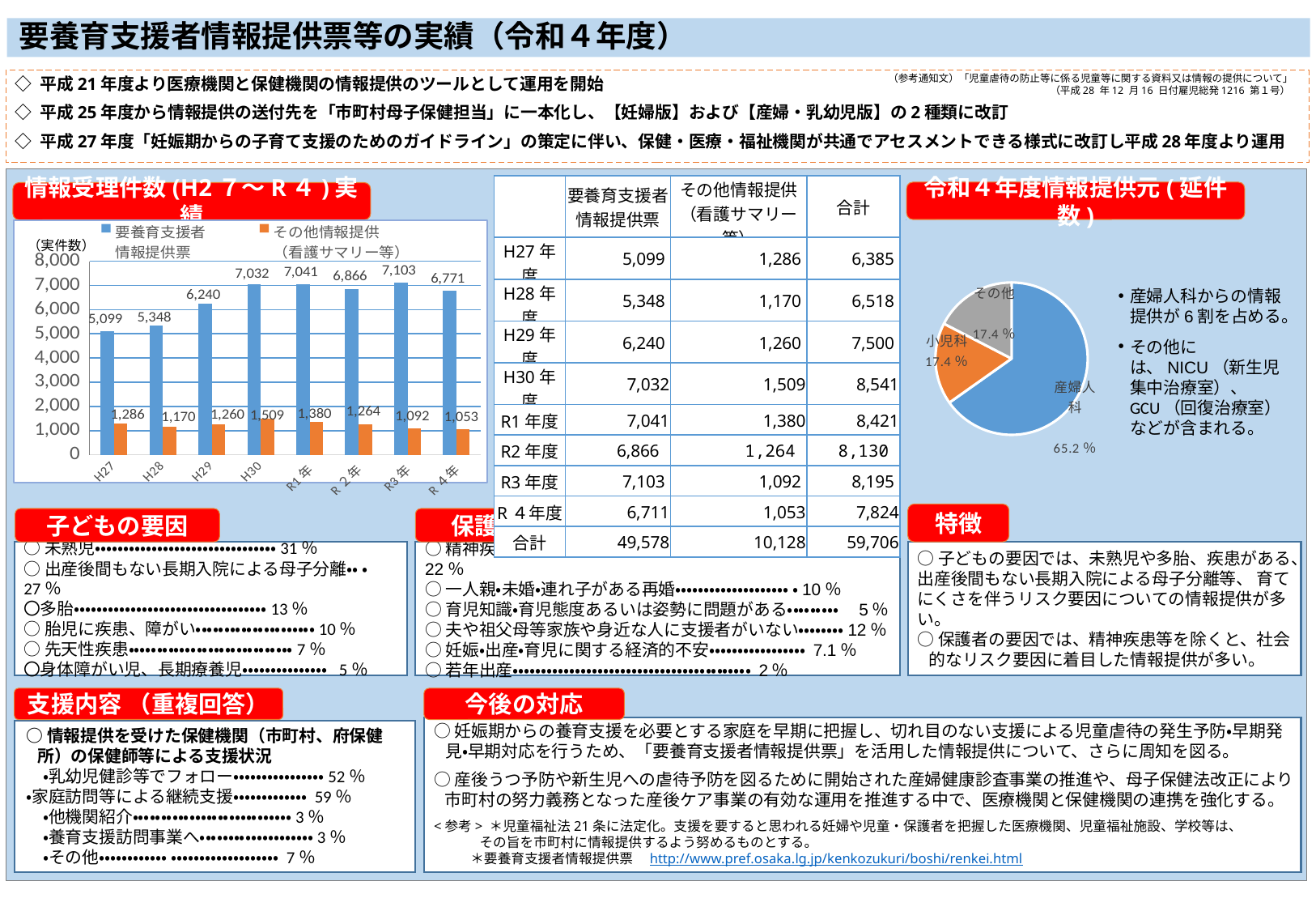
In the 情報受理件数(H27～R4)実績 chart, what is the difference between 要養育支援者情報提供票 and その他情報提供(看護サマリー等) for H27? 3,813 In the 令和4年度情報提供元(延件数) pie chart, what share does 産婦人科 have? 65.2% In the 情報受理件数(H27～R4)実績 chart, which year has the highest value for 要養育支援者情報提供票? R3年 How many slices does the 令和4年度情報提供元(延件数) pie chart have? 3 How many years are shown on the x axis of the 情報受理件数(H27～R4)実績 chart? 8 In the 情報受理件数(H27～R4)実績 chart, which year has the lowest value for その他情報提供(看護サマリー等)? R4年 In the 情報受理件数(H27～R4)実績 chart, what is the value of 要養育支援者情報提供票 for H30? 7,032 In the 情報受理件数(H27～R4)実績 chart, which is larger for 要養育支援者情報提供票: H28 or H29? H29 In the 情報受理件数(H27～R4)実績 chart, what is the value of その他情報提供(看護サマリー等) for R1年? 1,380 In the 情報受理件数(H27～R4)実績 chart, does the value of 要養育支援者情報提供票 rise or fall from H27 to H30? rise How many series does the legend of the 情報受理件数(H27～R4)実績 chart list? 2 What kind of chart is the 情報受理件数(H27～R4)実績 chart? bar chart